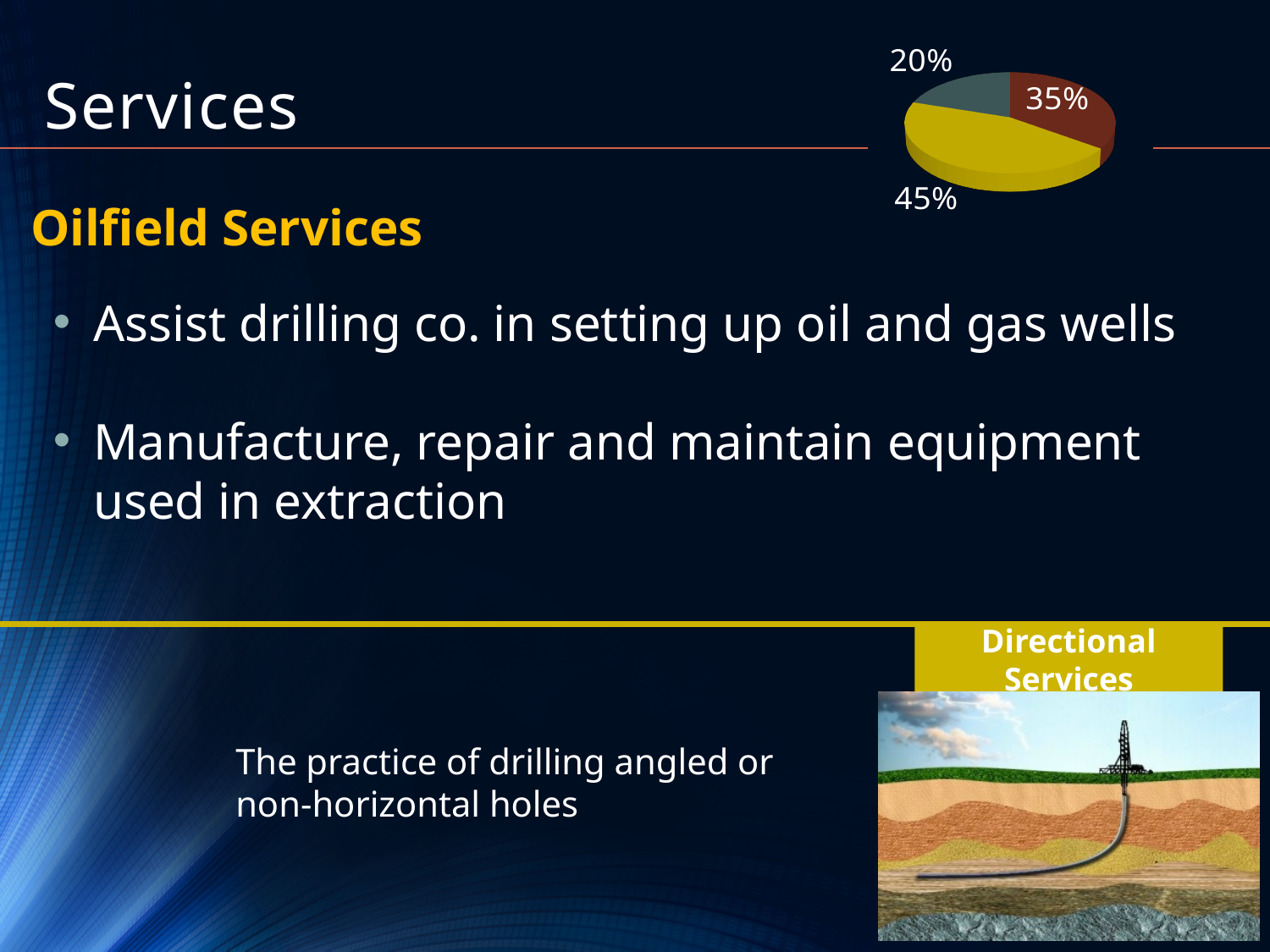
What kind of chart is shown in the top right of the slide? pie chart Does the pie chart include a legend with category names? No What percentage is shown for the yellow slice of the pie chart? 45% Which is larger in the pie chart, the dark red slice or the dark grey slice? the dark red slice How many slices does the pie chart have? 3 Which slice of the pie chart has the smallest share? the dark grey slice (20%) What do the three percentages in the pie chart add up to? 100% What percentage is shown for the dark grey slice of the pie chart? 20% Which slice of the pie chart has the largest share? the yellow slice (45%) What percentage is shown for the dark red slice of the pie chart? 35% What is the difference between the yellow slice and the dark red slice of the pie chart? 10% What is the difference between the largest and smallest slices of the pie chart? 25%